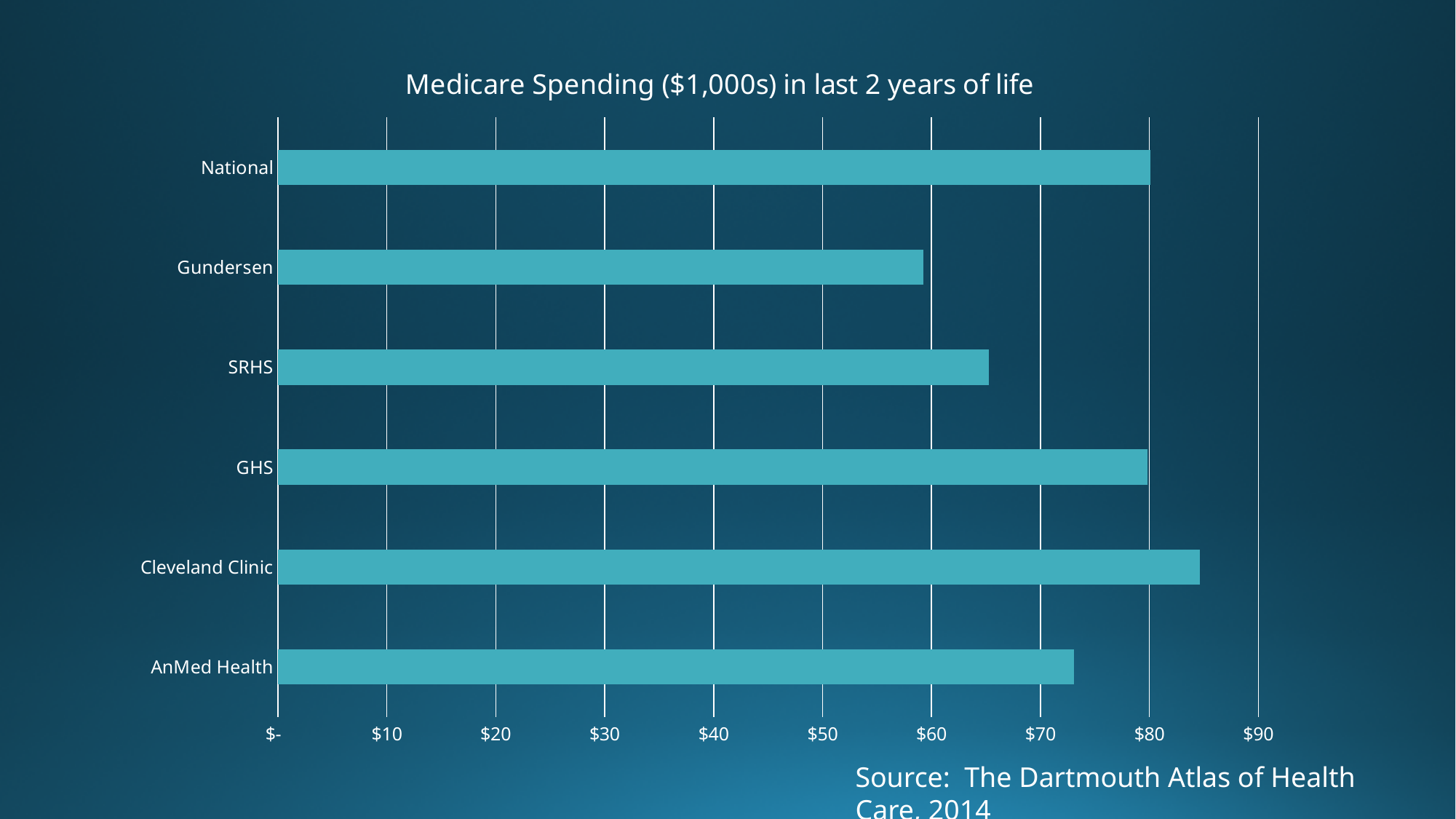
Which is larger, the value for Cleveland Clinic or the value for AnMed Health? Cleveland Clinic What kind of chart is shown on the slide? Bar chart Is the value for Gundersen greater or less than $60? less What source is cited for the chart data? The Dartmouth Atlas of Health Care, 2014 Is the value for AnMed Health greater or less than $70? greater Is the value for Cleveland Clinic greater or less than $80? greater How many categories are plotted in the chart? 6 What is the title of the chart? Medicare Spending ($1,000s) in last 2 years of life Which is larger, the value for SRHS or the value for Gundersen? SRHS Which category has the lowest Medicare spending? Gundersen Which category has the highest Medicare spending? Cleveland Clinic